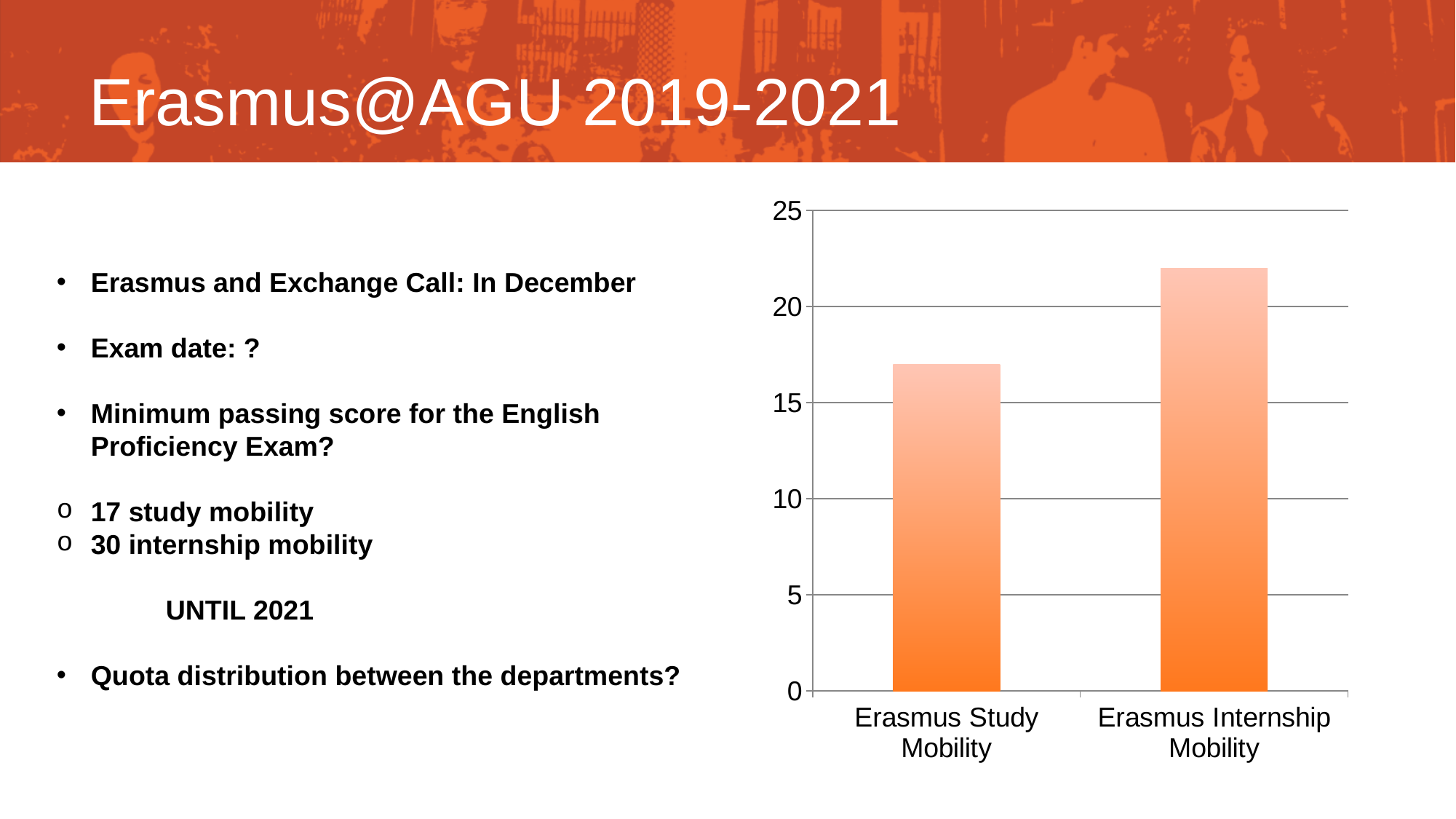
Is the value for Erasmus Study Mobility greater or less than 20? less What kind of chart is shown on the slide? bar chart Is the value for Erasmus Study Mobility greater or less than 15? greater Which is larger, the value for Erasmus Study Mobility or the value for Erasmus Internship Mobility? Erasmus Internship Mobility Is the value for Erasmus Internship Mobility greater or less than 25? less Which category has the lowest bar in the chart? Erasmus Study Mobility What is the label of the first category on the horizontal axis of the chart? Erasmus Study Mobility How many categories are plotted in the chart? 2 What is the highest value shown on the vertical axis of the chart? 25 Which category has the highest bar in the chart? Erasmus Internship Mobility